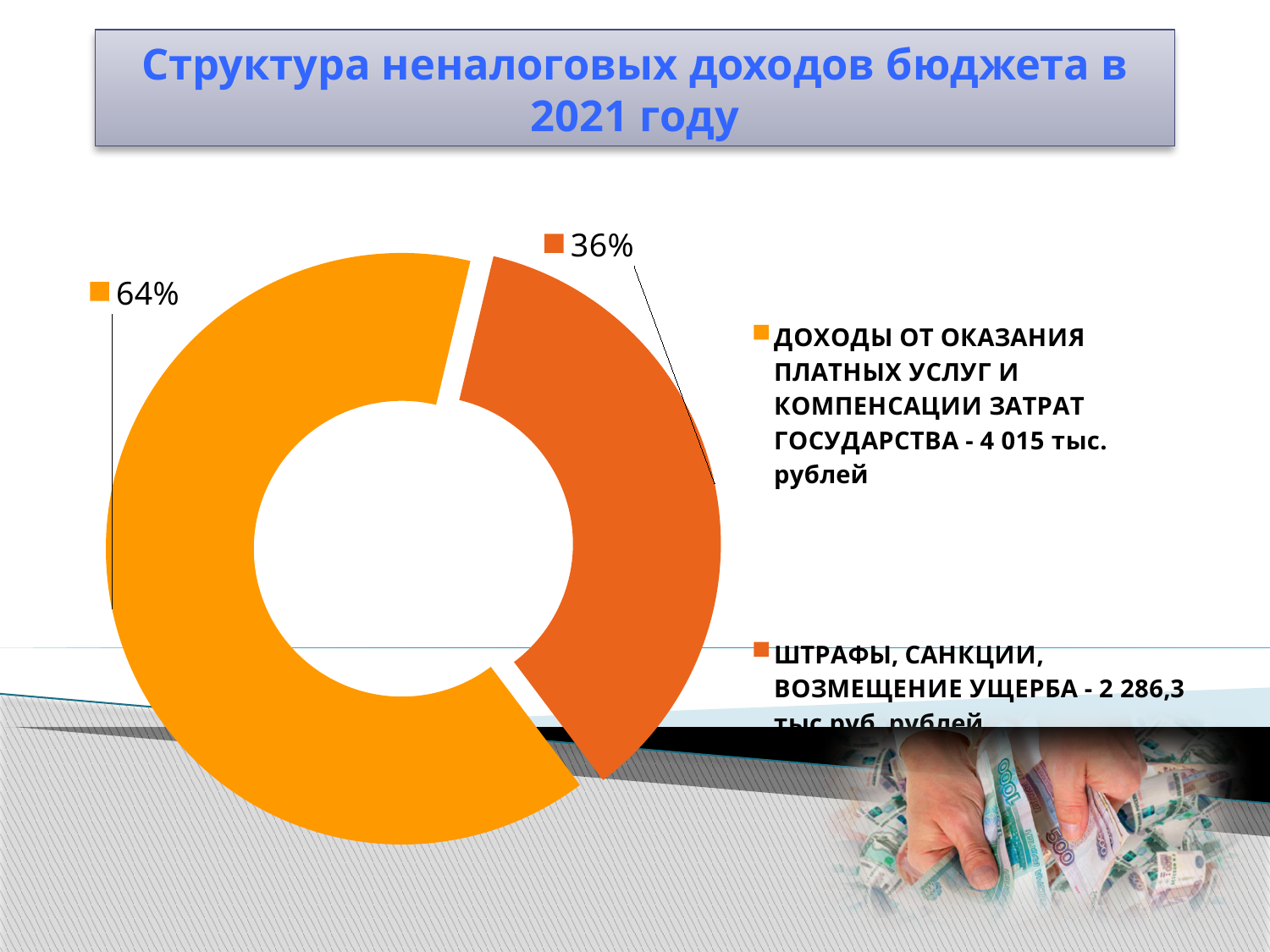
Что больше: доля доходов от оказания платных услуг или доля штрафов, санкций и возмещения ущерба? Доля доходов от оказания платных услуг Сколько категорий показано на диаграмме? 2 На сколько процентных пунктов доля доходов от оказания платных услуг больше доли штрафов, санкций и возмещения ущерба? 28 процентных пунктов Какова сумма доходов от оказания платных услуг и компенсации затрат государства, указанная в легенде? 4 015 тыс. рублей Каким цветом на диаграмме показан сегмент 64%? Жёлто-оранжевым Какая категория занимает наименьшую долю на диаграмме? Штрафы, санкции, возмещение ущерба Какая категория занимает наибольшую долю на диаграмме? Доходы от оказания платных услуг и компенсации затрат государства Как называется слайд с диаграммой? Структура неналоговых доходов бюджета в 2021 году Какую долю на диаграмме занимают штрафы, санкции, возмещение ущерба? 36% Какую долю на диаграмме занимают доходы от оказания платных услуг и компенсации затрат государства? 64% Какого типа диаграмма представлена на слайде? Кольцевая (круговая) диаграмма Какова сумма штрафов, санкций, возмещения ущерба, указанная в легенде? 2 286,3 тыс. руб.